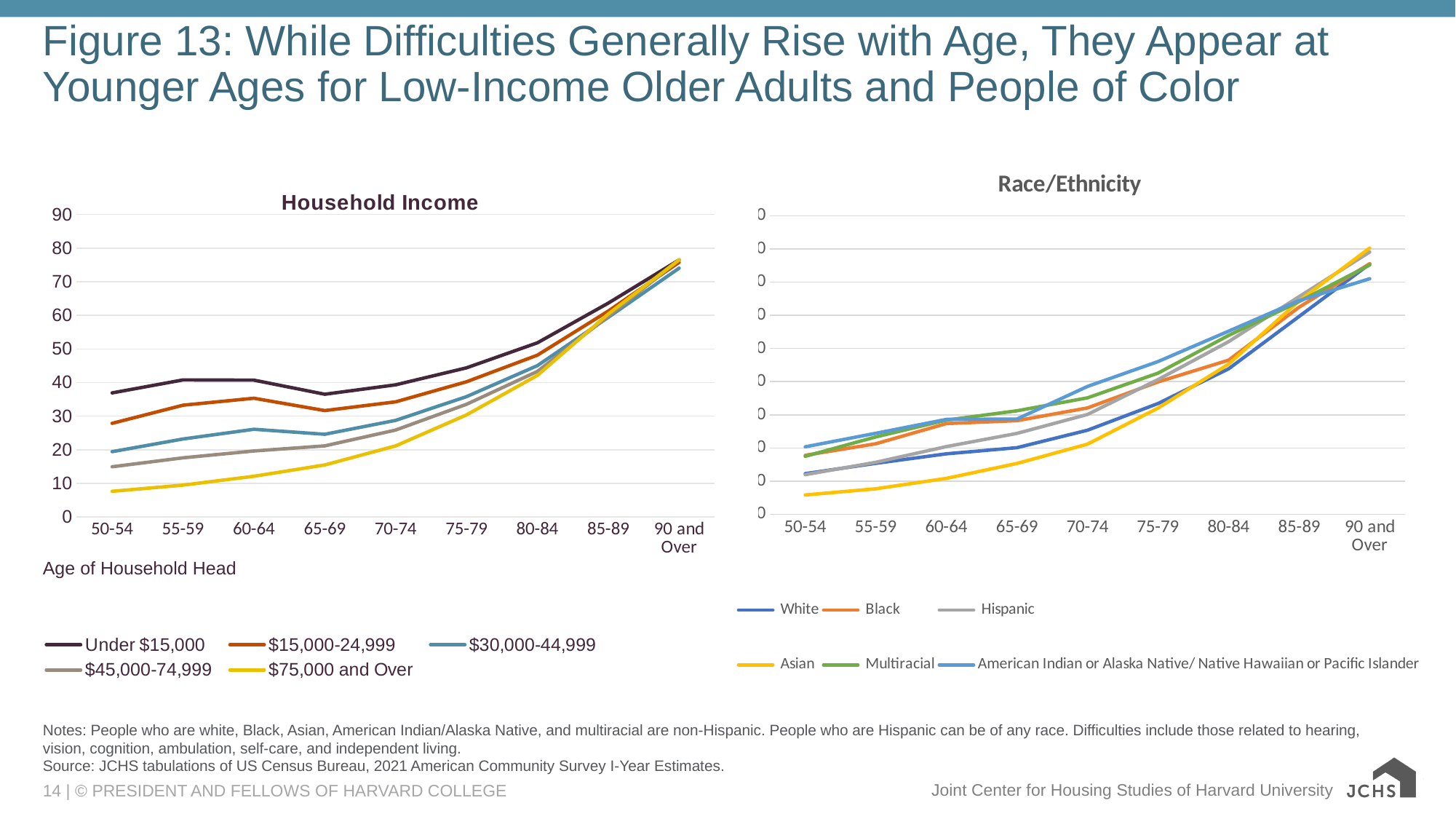
On the Race/Ethnicity chart, how many series does the legend list? 6 On the Household Income chart, is the value for Under $15,000 at age 50-54 greater or less than 30? greater On the Household Income chart, at age 60-64, which is larger: Under $15,000 or $30,000-44,999? Under $15,000 On the Household Income chart, how many age groups are shown on the x axis? 9 On the Race/Ethnicity chart, which group has the lowest value at age 50-54? Asian On the Household Income chart, how many series does the legend list? 5 On the Household Income chart, which income group has the lowest value at age 50-54? $75,000 and Over On the Race/Ethnicity chart, at age 70-74, which is larger: Black or Asian? Black On the Household Income chart, which income group has the highest value at age 50-54? Under $15,000 On the Household Income chart, is the value for $75,000 and Over at age 50-54 greater or less than 10? less On the Household Income chart, what kind of chart is shown? Line chart On the Household Income chart, do the values for $75,000 and Over generally rise or fall as age increases? Rise